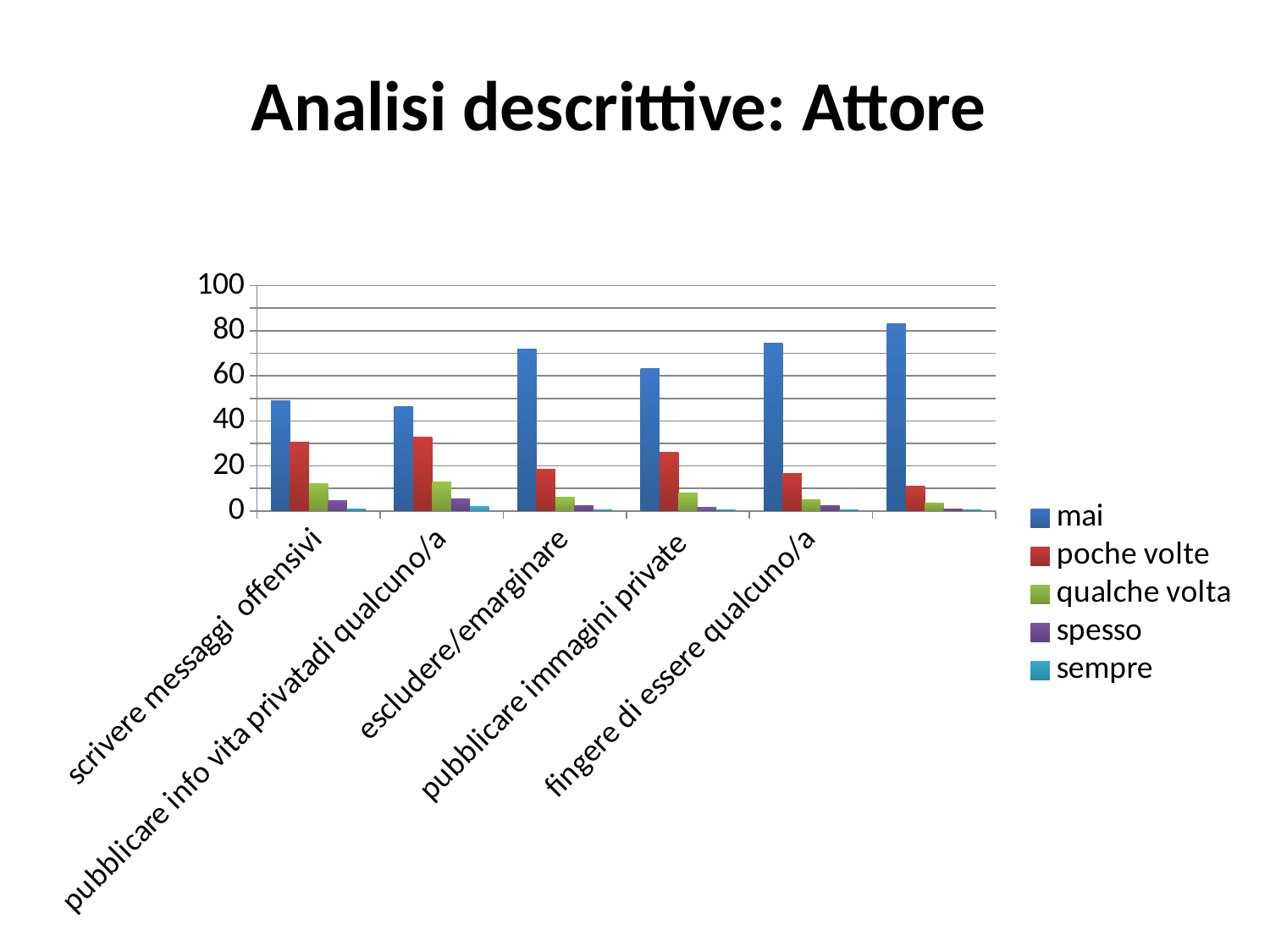
How many series does the legend list? 5 What kind of chart is shown on the slide? bar chart For "pubblicare info vita privata di qualcuno/a", which series has the highest value? mai Is the value of "mai" for "escludere/emarginare" greater or less than 60? greater Is the value of "poche volte" for "scrivere messaggi offensivi" greater or less than 20? greater Is the value of "mai" for "fingere di essere qualcuno/a" greater or less than 60? greater For "pubblicare immagini private", which is larger: "mai" or "poche volte"? mai What is the title of the slide? Analisi descrittive: Attore Which colour represents the series "mai" in the chart? blue For "escludere/emarginare", which is larger: "qualche volta" or "poche volte"? poche volte